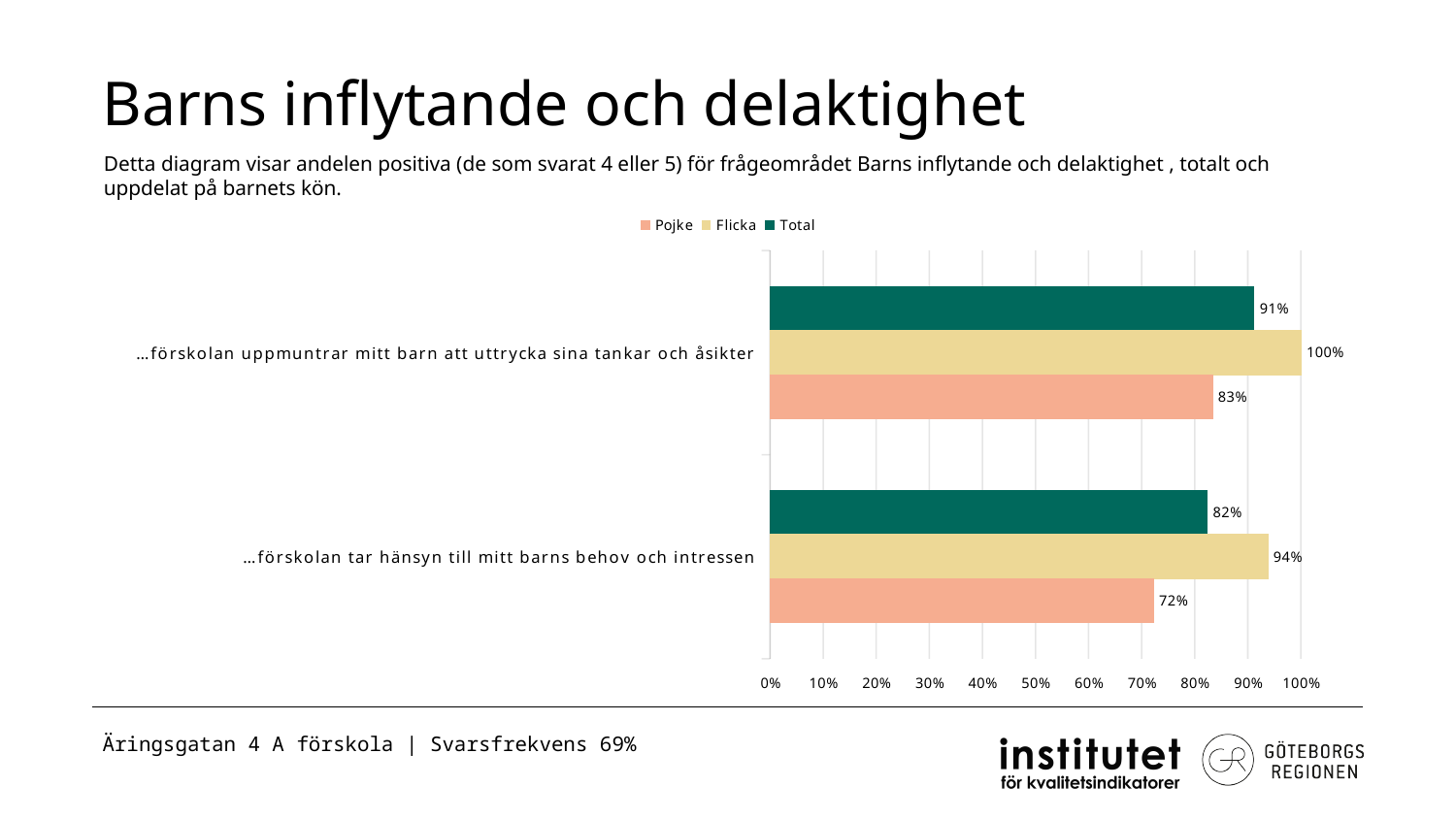
How many categories are shown on the chart? 2 Which series has the lowest value for "…förskolan uppmuntrar mitt barn att uttrycka sina tankar och åsikter"? Pojke What is the difference between the Flicka and Pojke values for "…förskolan tar hänsyn till mitt barns behov och intressen"? 22% Which is larger: the Total value for "…förskolan uppmuntrar mitt barn att uttrycka sina tankar och åsikter" or the Flicka value for "…förskolan tar hänsyn till mitt barns behov och intressen"? Flicka value for "…förskolan tar hänsyn till mitt barns behov och intressen" How many series does the legend list? 3 What is the Pojke value for "…förskolan tar hänsyn till mitt barns behov och intressen"? 72% What kind of chart is shown on the slide? Bar chart What is the Total value for "…förskolan tar hänsyn till mitt barns behov och intressen"? 82% What is the Pojke value for "…förskolan uppmuntrar mitt barn att uttrycka sina tankar och åsikter"? 83% What is the Flicka value for "…förskolan uppmuntrar mitt barn att uttrycka sina tankar och åsikter"? 100% Which series has the highest value for "…förskolan tar hänsyn till mitt barns behov och intressen"? Flicka What is the difference between the Total values of the two categories? 9%